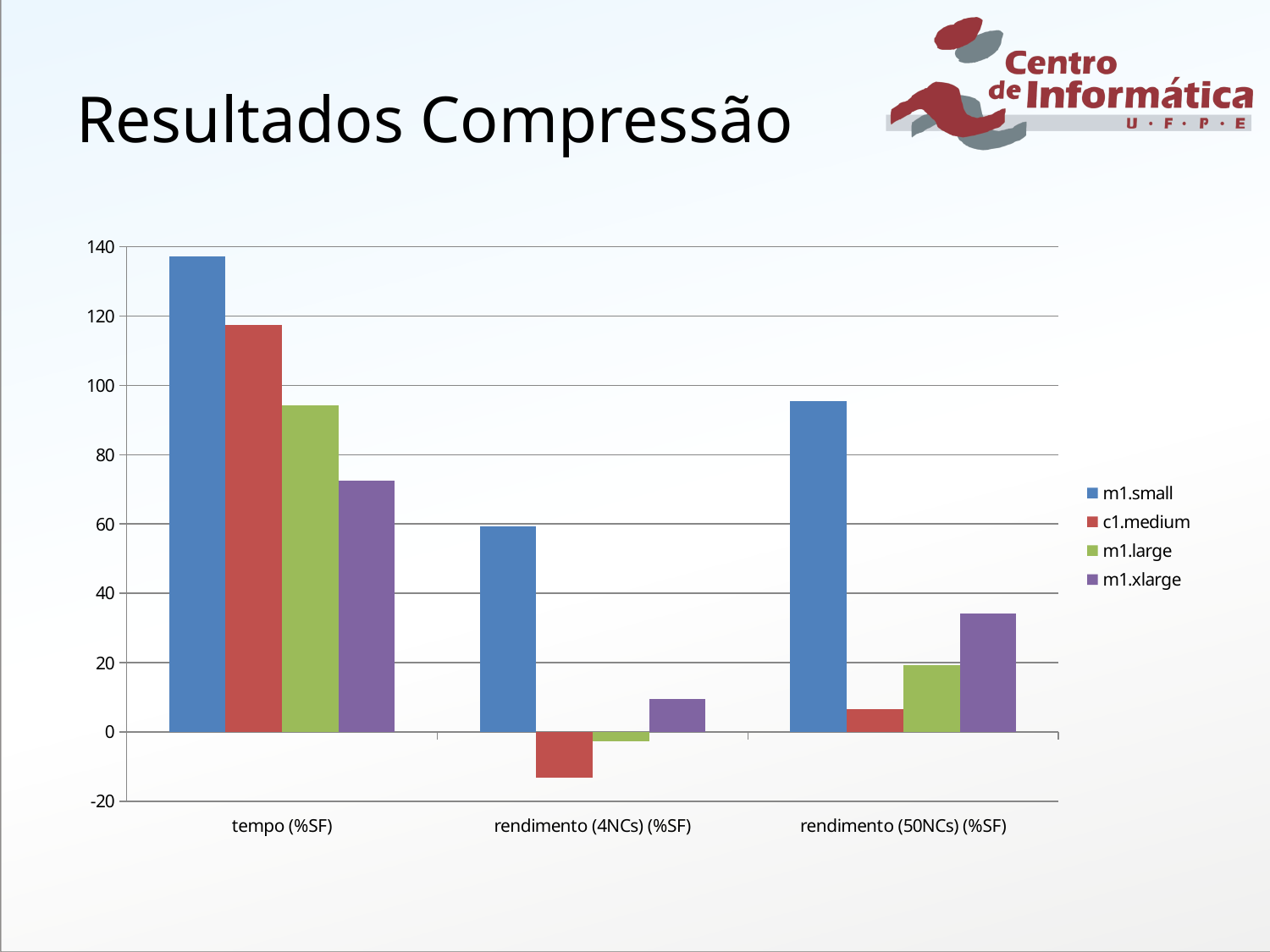
Is the value for m1.xlarge in the tempo (%SF) category greater or less than 80? less Is the value for c1.medium in the rendimento (4NCs) (%SF) category greater or less than 0? less Is the value for m1.small in the tempo (%SF) category greater or less than 120? greater Which is larger: m1.xlarge in rendimento (50NCs) (%SF) or m1.large in rendimento (50NCs) (%SF)? m1.xlarge in rendimento (50NCs) (%SF) How many series does the legend list? 4 What kind of chart is shown on the slide? bar chart What colour represents the m1.large series in the legend? green Which series has the highest value in the tempo (%SF) category? m1.small Which series has the lowest value in the rendimento (50NCs) (%SF) category? c1.medium How many categories are shown on the x axis? 3 Which series has the lowest value in the rendimento (4NCs) (%SF) category? c1.medium